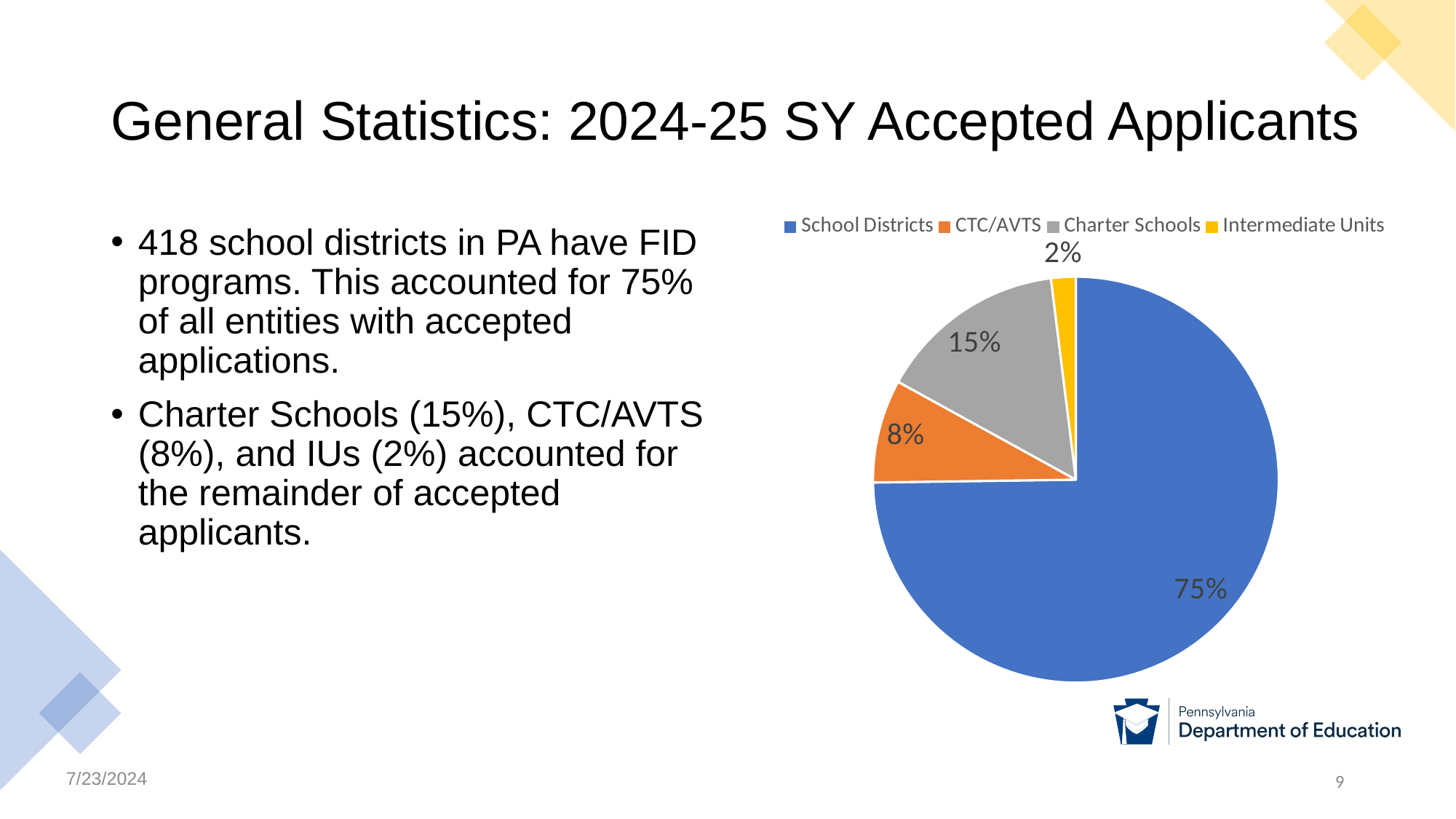
Which category is shown in yellow in the legend? Intermediate Units What share of the pie does School Districts account for? 75% Which slice is larger, CTC/AVTS or Charter Schools? Charter Schools What is the difference in percentage points between the School Districts slice and the Charter Schools slice? 60 Which category has the smallest slice of the pie? Intermediate Units Which category has the largest slice of the pie? School Districts What colour is the School Districts slice? blue What share of the pie does Intermediate Units account for? 2% What share of the pie does CTC/AVTS account for? 8% How many categories does the pie chart show? 4 What kind of chart is shown on the slide? pie chart